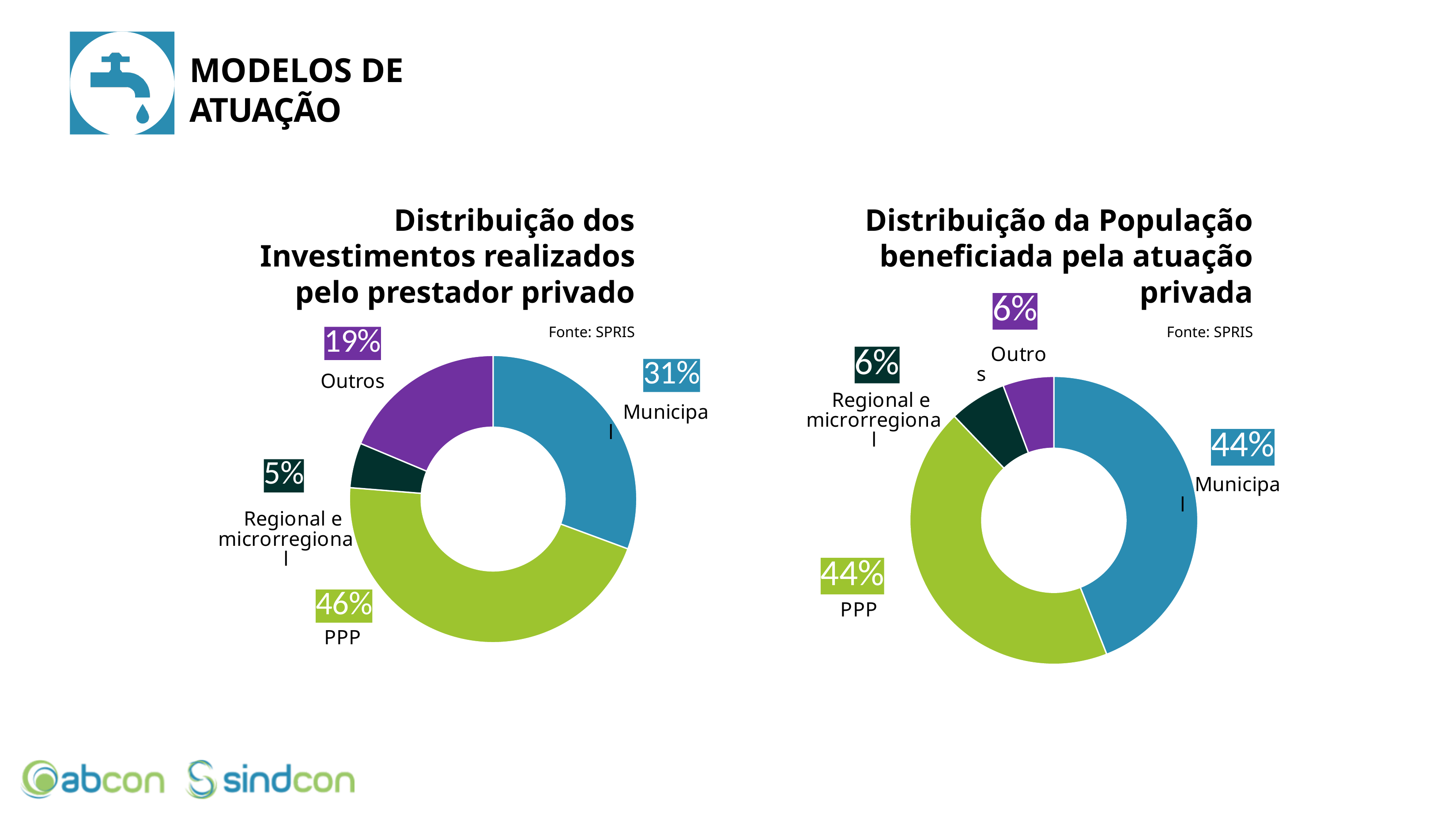
How many categories does the chart 'Distribuição da População beneficiada pela atuação privada' show? 4 In the chart 'Distribuição dos Investimentos realizados pelo prestador privado', which is larger, Outros or Regional e microrregional? Outros In the chart 'Distribuição dos Investimentos realizados pelo prestador privado', what is the difference in percentage points between PPP and Municipal? 15 In the chart 'Distribuição dos Investimentos realizados pelo prestador privado', what share is Municipal? 31% What type of chart is 'Distribuição dos Investimentos realizados pelo prestador privado'? Donut (pie) chart In the chart 'Distribuição dos Investimentos realizados pelo prestador privado', which category has the largest share? PPP In the chart 'Distribuição dos Investimentos realizados pelo prestador privado', what share is Regional e microrregional? 5% In the chart 'Distribuição dos Investimentos realizados pelo prestador privado', what share is PPP? 46% In the chart 'Distribuição da População beneficiada pela atuação privada', which is larger, PPP or Regional e microrregional? PPP In the chart 'Distribuição da População beneficiada pela atuação privada', what share is Municipal? 44% In the chart 'Distribuição dos Investimentos realizados pelo prestador privado', which category has the smallest share? Regional e microrregional In the chart 'Distribuição da População beneficiada pela atuação privada', what share is Outros? 6%